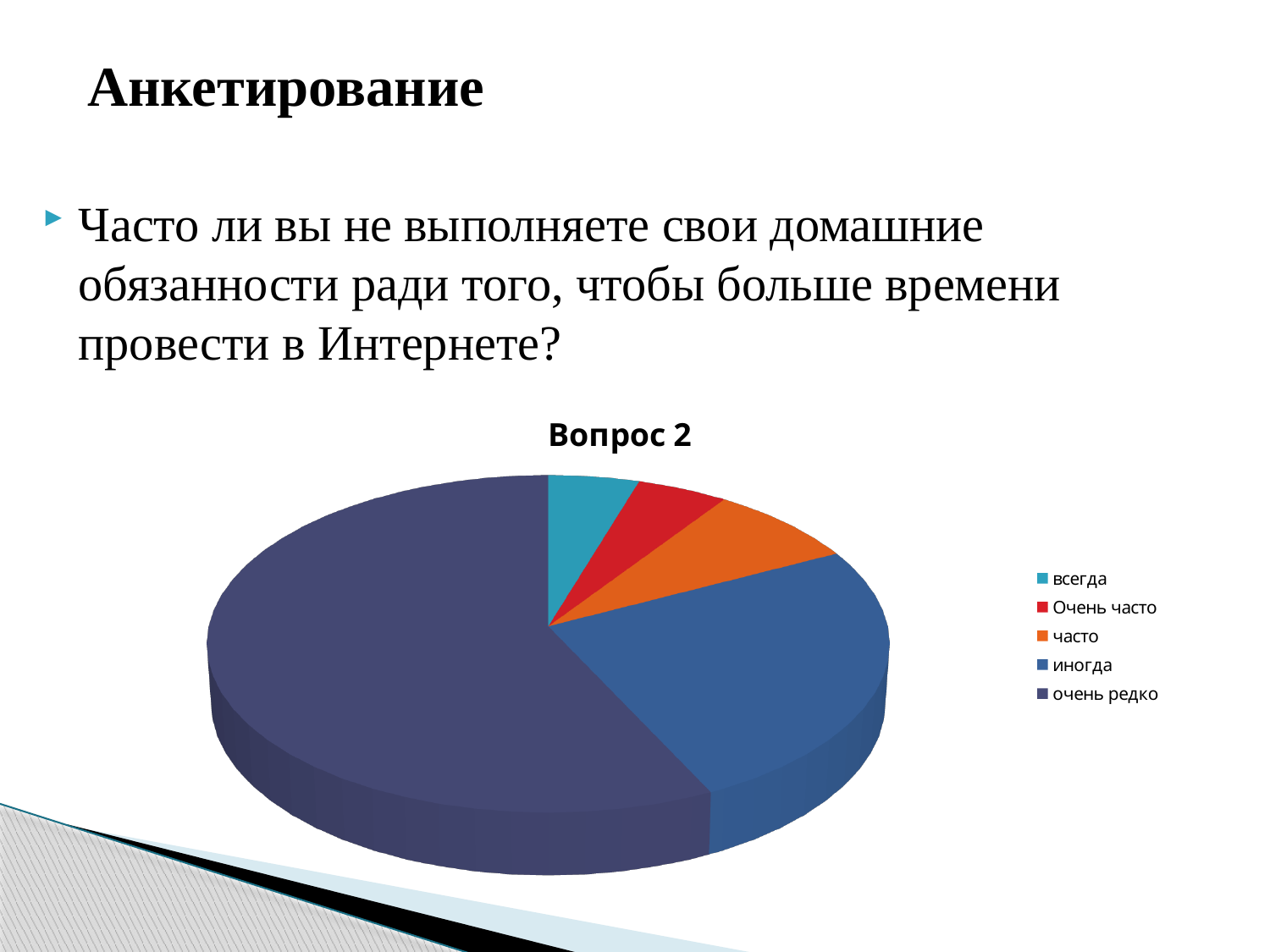
Which category is shown in red in the legend? Очень часто Which slice is larger, "иногда" or "часто"? иногда Which category has the largest slice of the pie? очень редко What kind of chart is shown on the slide? pie chart How many categories (slices) does the pie chart have? 5 What is the title of the chart? Вопрос 2 Which slice is larger, "иногда" or "всегда"? иногда How many entries does the chart legend list? 5 Which slice is larger, "очень редко" or "иногда"? очень редко